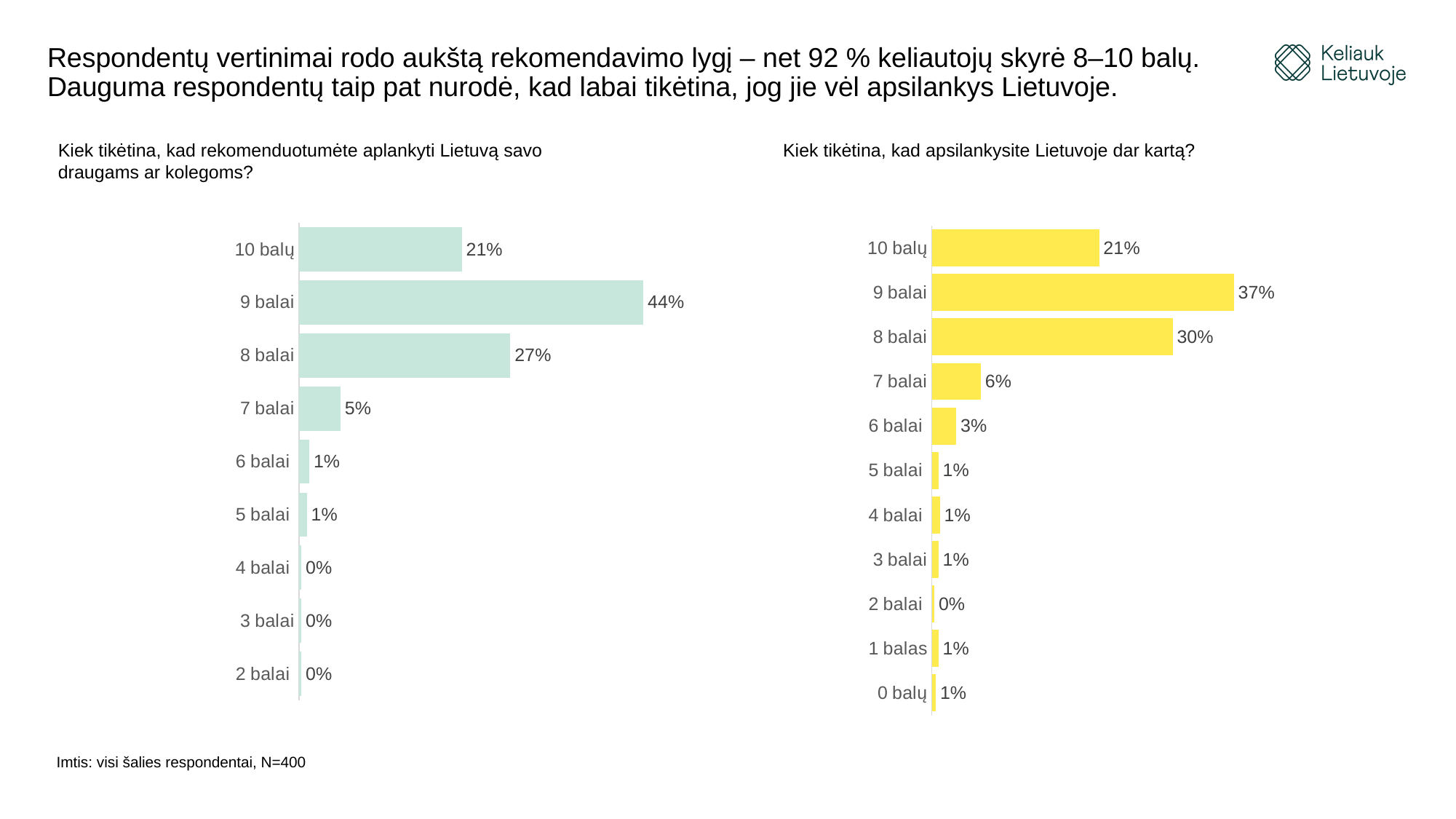
What type of chart is used on the left side of the slide? Bar chart In the right chart, which is larger: the percentage for 7 balai or for 6 balai? 7 balai What colour are the bars in the right chart? Yellow In the left chart, what is the combined percentage for 8 balai, 9 balai and 10 balų? 92% In the left chart, what is the difference between the percentages for 9 balai and 8 balai? 17% In the right chart, which score category has the highest percentage? 9 balai In the right chart, what is the difference between the percentages for 9 balai and 10 balų? 16% How many score categories are shown in the left chart? 9 How many score categories are shown in the right chart? 11 In the left chart, which score category has the highest percentage? 9 balai In the left chart (recommending Lithuania to friends or colleagues), what percentage of respondents gave 9 balai? 44% In the right chart (likelihood of visiting Lithuania again), what percentage of respondents gave 8 balai? 30%